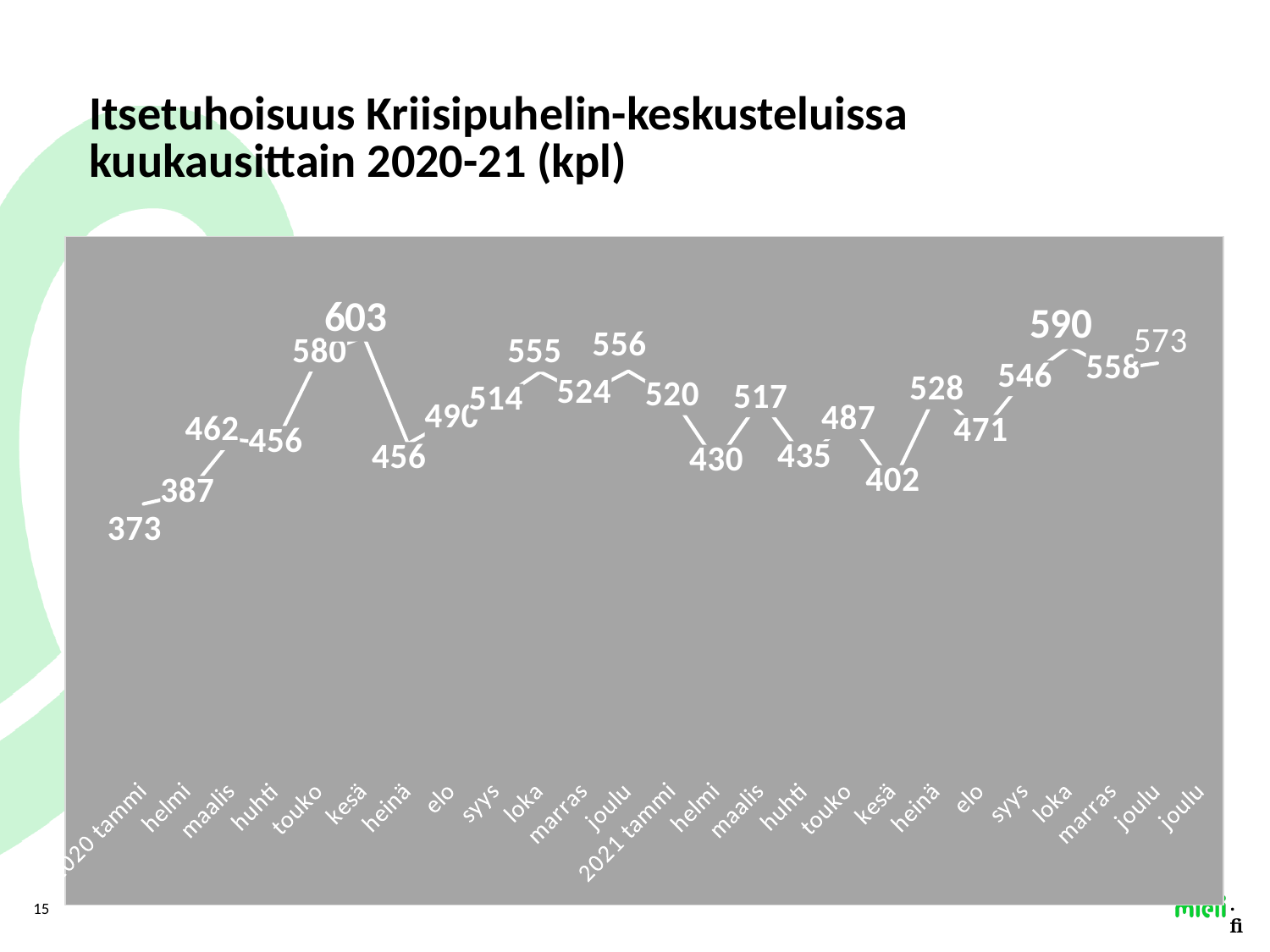
What is the value for kesä 2021? 402 What is the value for 2020 tammi? 373 What is the value for kesä 2020? 603 What is the value for loka 2021? 590 What kind of chart is shown on the slide? line chart What is the difference between the highest value (603) and the lowest value (373)? 230 What is the difference between the values for loka 2021 and kesä 2021? 188 Which is larger, the value for touko 2020 or the value for touko 2021? touko 2020 Which month has the highest value? kesä 2020 Which month has the lowest value? 2020 tammi What is the title of the chart? Itsetuhoisuus Kriisipuhelin-keskusteluissa kuukausittain 2020-21 (kpl) Do the values rise or fall from 2020 tammi to kesä 2020? rise